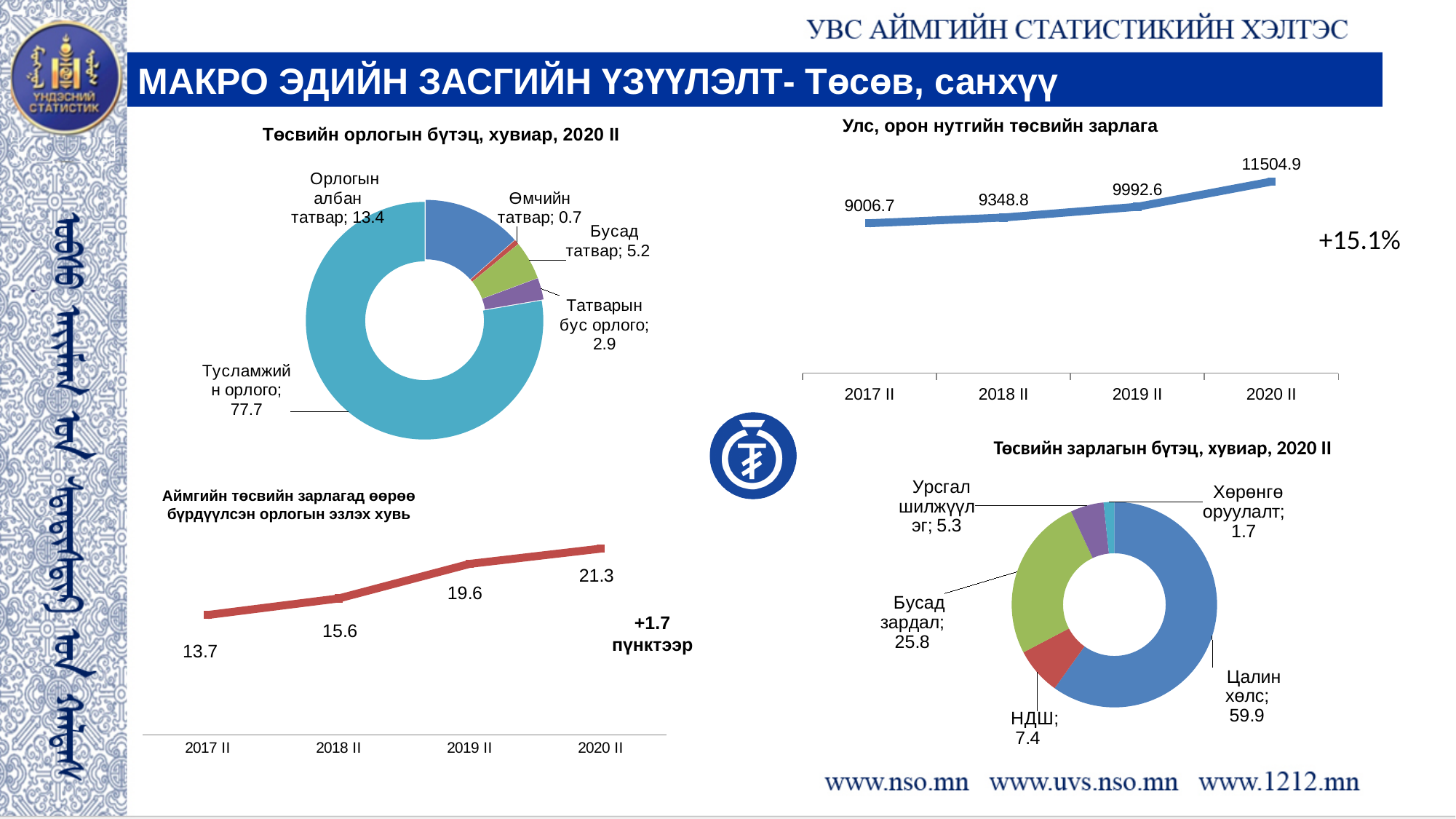
In the chart titled 'Төсвийн орлогын бүтэц, хувиар, 2020 II', how many categories are shown? 5 In the chart titled 'Улс, орон нутгийн төсвийн зарлага', what is the value for 2020 II? 11504.9 In the chart titled 'Улс, орон нутгийн төсвийн зарлага', what is the difference between the 2020 II and 2017 II values? 2498.2 In the chart titled 'Төсвийн орлогын бүтэц, хувиар, 2020 II', which category has the smallest share? Өмчийн татвар What type of chart is 'Улс, орон нутгийн төсвийн зарлага'? line chart What type of chart is 'Төсвийн зарлагын бүтэц, хувиар, 2020 II'? doughnut chart In the chart titled 'Төсвийн зарлагын бүтэц, хувиар, 2020 II', which is larger: НДШ or Урсгал шилжүүлэг? НДШ In the chart titled 'Аймгийн төсвийн зарлагад өөрөө бүрдүүлсэн орлогын эзлэх хувь', which year has the highest value? 2020 II In the chart titled 'Аймгийн төсвийн зарлагад өөрөө бүрдүүлсэн орлогын эзлэх хувь', what is the value for 2018 II? 15.6 In the chart titled 'Төсвийн зарлагын бүтэц, хувиар, 2020 II', what is the value for Бусад зардал? 25.8 In the chart titled 'Улс, орон нутгийн төсвийн зарлага', do the values rise or fall from 2017 II to 2020 II? rise In the chart titled 'Төсвийн орлогын бүтэц, хувиар, 2020 II', what is the value for Тусламжийн орлого? 77.7